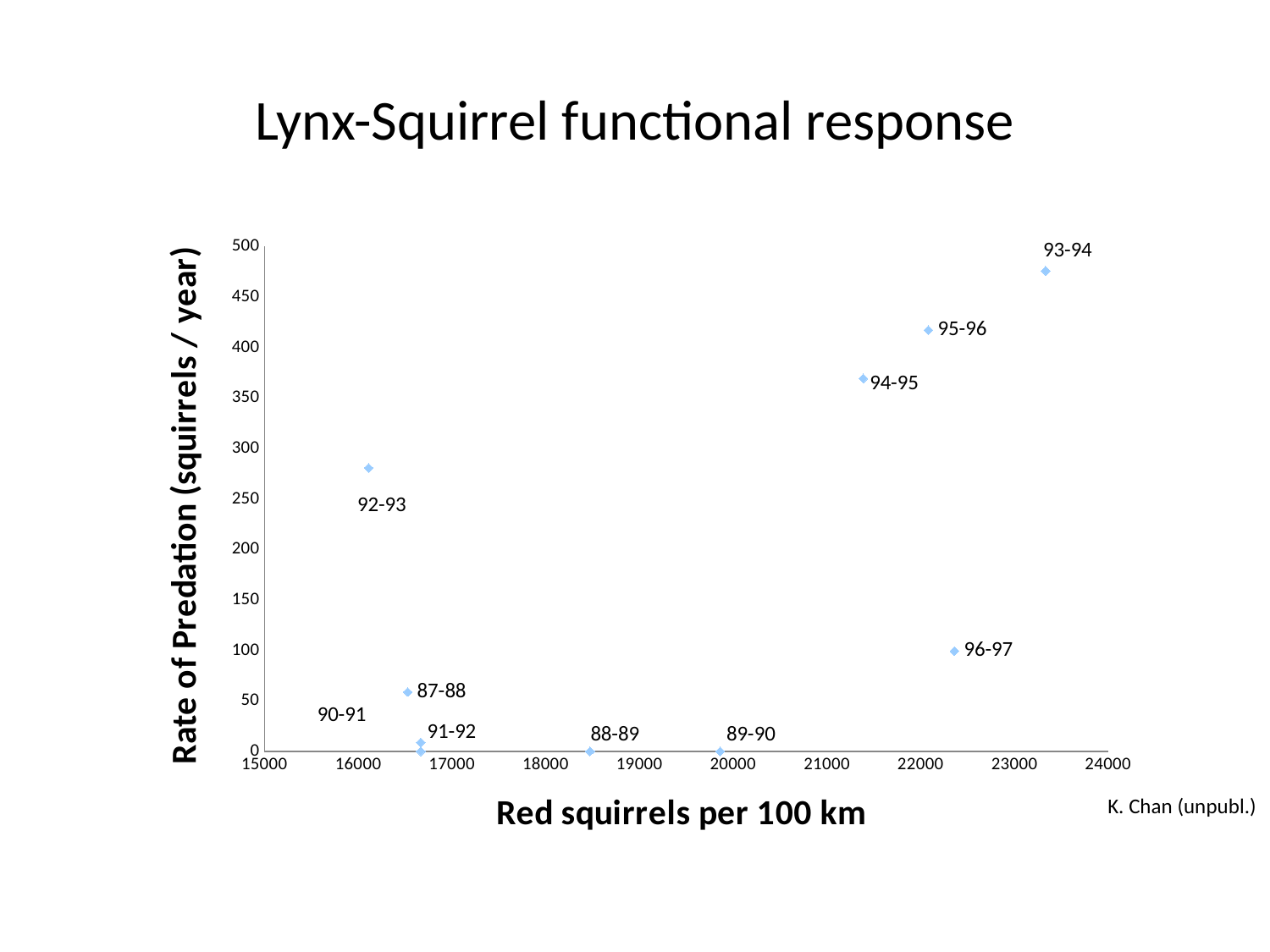
What is the title of the chart? Lynx-Squirrel functional response What kind of chart is shown on the slide? scatter chart Is the rate of predation for 92-93 greater or less than 250? greater Is the rate of predation for 94-95 greater or less than 300? greater Which labeled point has the highest rate of predation? 93-94 Is the rate of predation for 87-88 greater or less than 100? less Which has a higher rate of predation, 92-93 or 96-97? 92-93 How many data points are plotted on the chart? 10 Which has a higher rate of predation, 93-94 or 95-96? 93-94 What is the label of the x axis? Red squirrels per 100 km